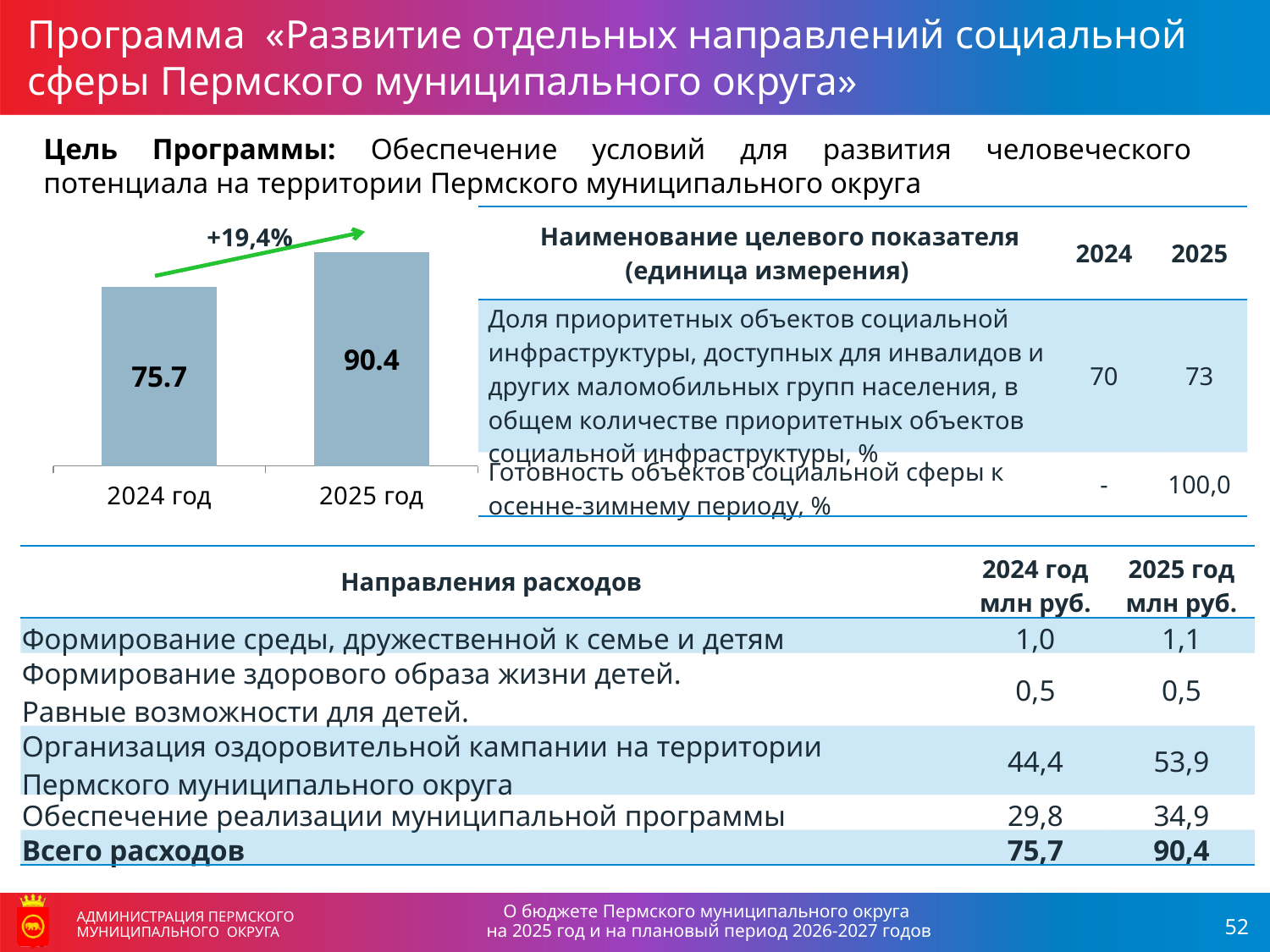
Do the values rise or fall from 2024 год to 2025 год in the chart? rise What colour are the bars in the chart? grey-blue What is the difference between the 2025 год and 2024 год values in the bar chart? 14.7 Is the value for 2024 год larger or smaller than the value for 2025 год? smaller Which year has the lower bar in the chart? 2024 год Which year has the higher bar in the chart? 2025 год How many bars are shown in the chart? 2 What percentage change is annotated above the bars in the chart? +19,4% What kind of chart is shown on the slide? bar chart What is the value for 2025 год in the bar chart? 90.4 What is the value for 2024 год in the bar chart? 75.7